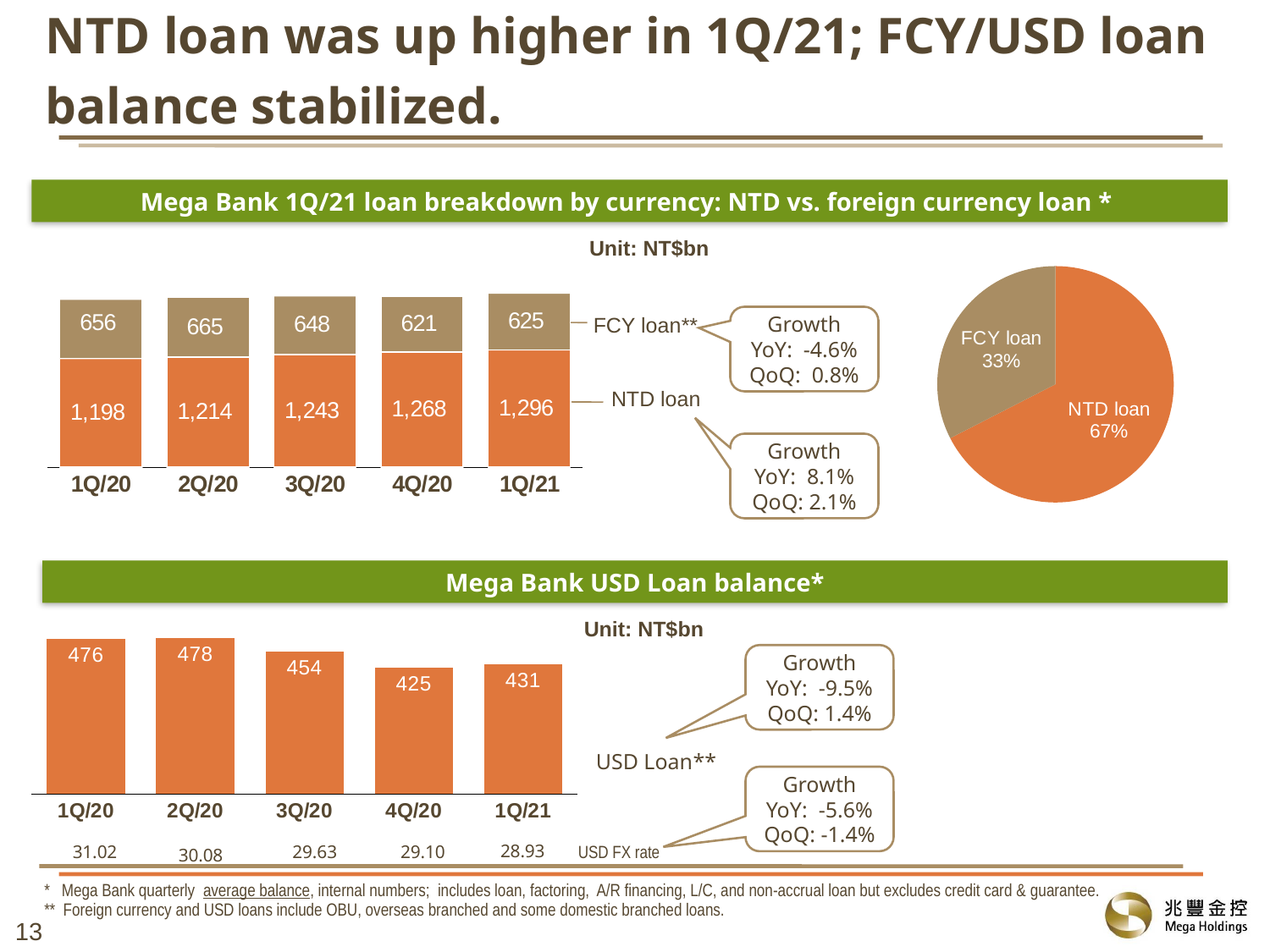
In the 'Mega Bank 1Q/21 loan breakdown by currency' stacked bar chart, does the NTD loan rise or fall from 1Q/20 to 1Q/21? Rise In the 'Mega Bank 1Q/21 loan breakdown by currency' stacked bar chart, what is the FCY loan value for 2Q/20? 665 In the pie chart on the right of the slide, which slice is larger, NTD loan or FCY loan? NTD loan In the 'Mega Bank 1Q/21 loan breakdown by currency' stacked bar chart, what is the total of the 1Q/20 bar (NTD loan plus FCY loan)? 1,854 In the 'Mega Bank USD Loan balance' bar chart, what is the difference between the 2Q/20 and 4Q/20 values? 53 In the pie chart on the right of the slide, what share does the FCY loan have? 33% In the 'Mega Bank USD Loan balance' bar chart, what is the value for 3Q/20? 454 In the 'Mega Bank 1Q/21 loan breakdown by currency' stacked bar chart, how much higher is the NTD loan in 1Q/21 than in 1Q/20? 98 In the 'Mega Bank 1Q/21 loan breakdown by currency' stacked bar chart, what is the NTD loan value for 1Q/21? 1,296 In the 'Mega Bank 1Q/21 loan breakdown by currency' stacked bar chart, which quarter has the lowest FCY loan value? 4Q/20 In the 'Mega Bank USD Loan balance' bar chart, which quarter has the highest value? 2Q/20 How many quarters are shown on the x axis of the 'Mega Bank USD Loan balance' bar chart? 5